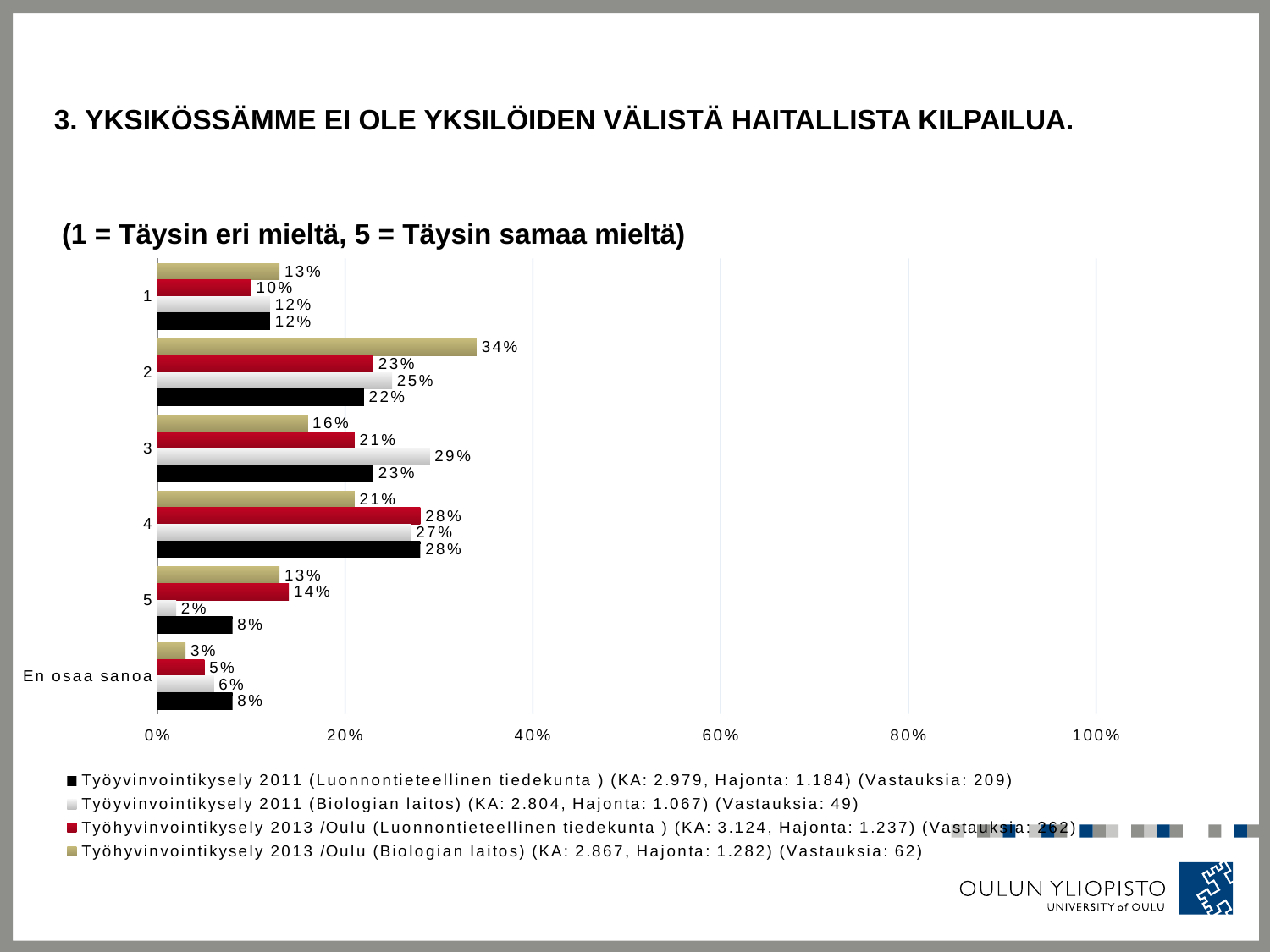
Which category has the highest value in the Työhyvinvointikysely 2013 /Oulu (Biologian laitos) series? 2 How many series does the legend list? 4 What is the value for category 5 in the Työhyvinvointikysely 2013 /Oulu (Luonnontieteellinen tiedekunta) series? 14% What kind of chart is shown on the slide? bar chart What is the value for category 2 in the Työhyvinvointikysely 2013 /Oulu (Biologian laitos) series? 34% What is the difference between the Työhyvinvointikysely 2013 /Oulu (Biologian laitos) value and the Työyvinvointikysely 2011 (Luonnontieteellinen tiedekunta) value for category 2? 12% What is the value for 'En osaa sanoa' in the Työyvinvointikysely 2011 (Luonnontieteellinen tiedekunta) series? 8% For category 3, which is larger: the Työyvinvointikysely 2011 (Biologian laitos) value or the Työhyvinvointikysely 2013 /Oulu (Biologian laitos) value? Työyvinvointikysely 2011 (Biologian laitos) Which category has the lowest value in the Työyvinvointikysely 2011 (Biologian laitos) series? 5 Is the value for category 4 in the Työhyvinvointikysely 2013 /Oulu (Luonnontieteellinen tiedekunta) series greater or less than 20%? greater What is the value for category 3 in the Työyvinvointikysely 2011 (Biologian laitos) series? 29% How many categories are shown on the vertical axis? 6